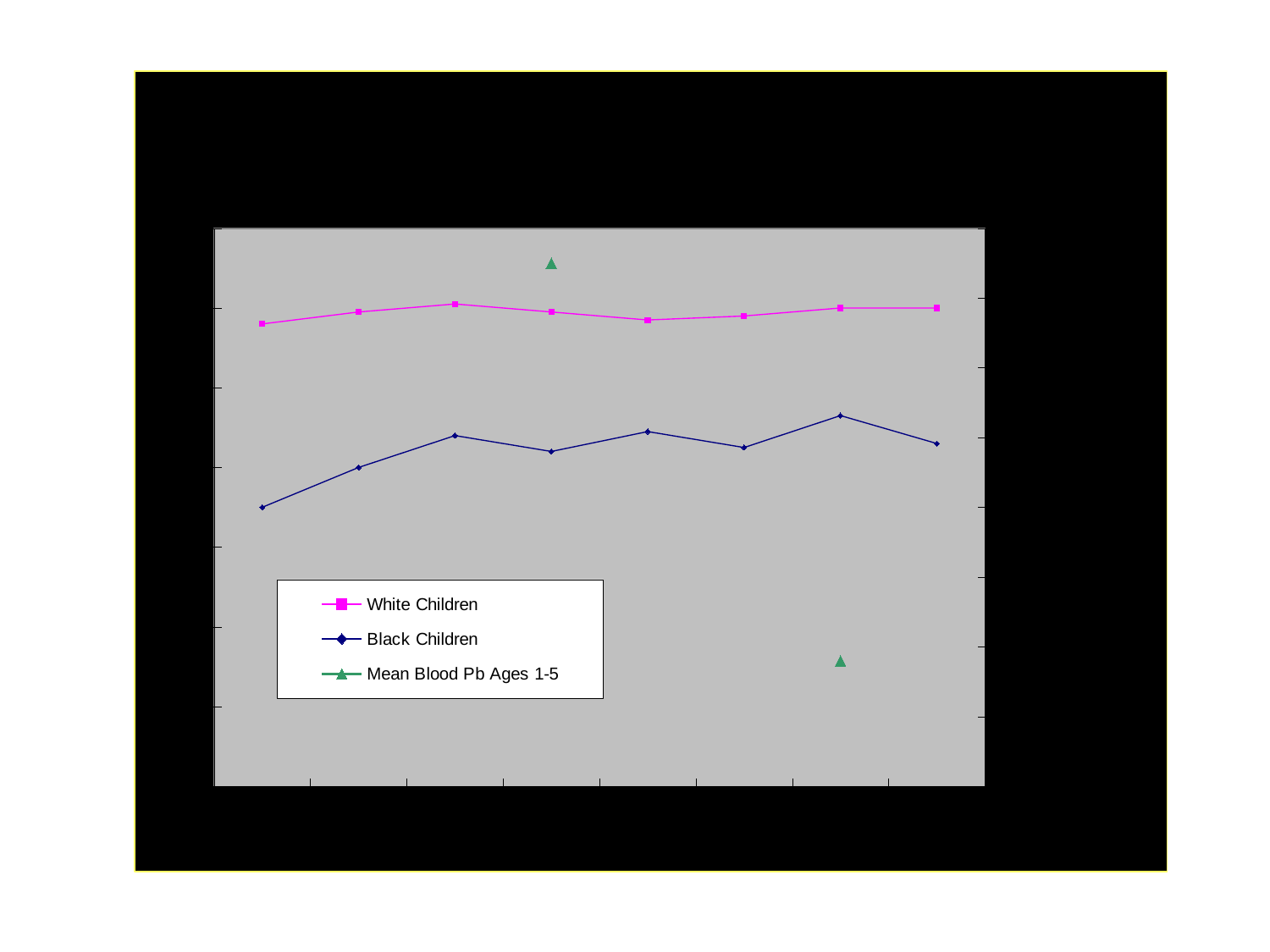
What colour is the line for White Children? Magenta (pink) Does the Black Children line end higher or lower than it starts? Higher Which series is plotted higher on the chart throughout, White Children or Black Children? White Children Does the Mean Blood Pb Ages 1-5 series rise or fall from its first point to its second point? Fall Which series has the highest plotted point on the chart? Mean Blood Pb Ages 1-5 How many data points are plotted on the Black Children line? 8 What kind of chart is shown on the slide? Line chart What are the three series named in the legend? White Children, Black Children, Mean Blood Pb Ages 1-5 How many data points are plotted on the White Children line? 8 How many points are plotted for the Mean Blood Pb Ages 1-5 series? 2 How many series does the legend list? 3 Which series has the lowest plotted point on the chart? Mean Blood Pb Ages 1-5